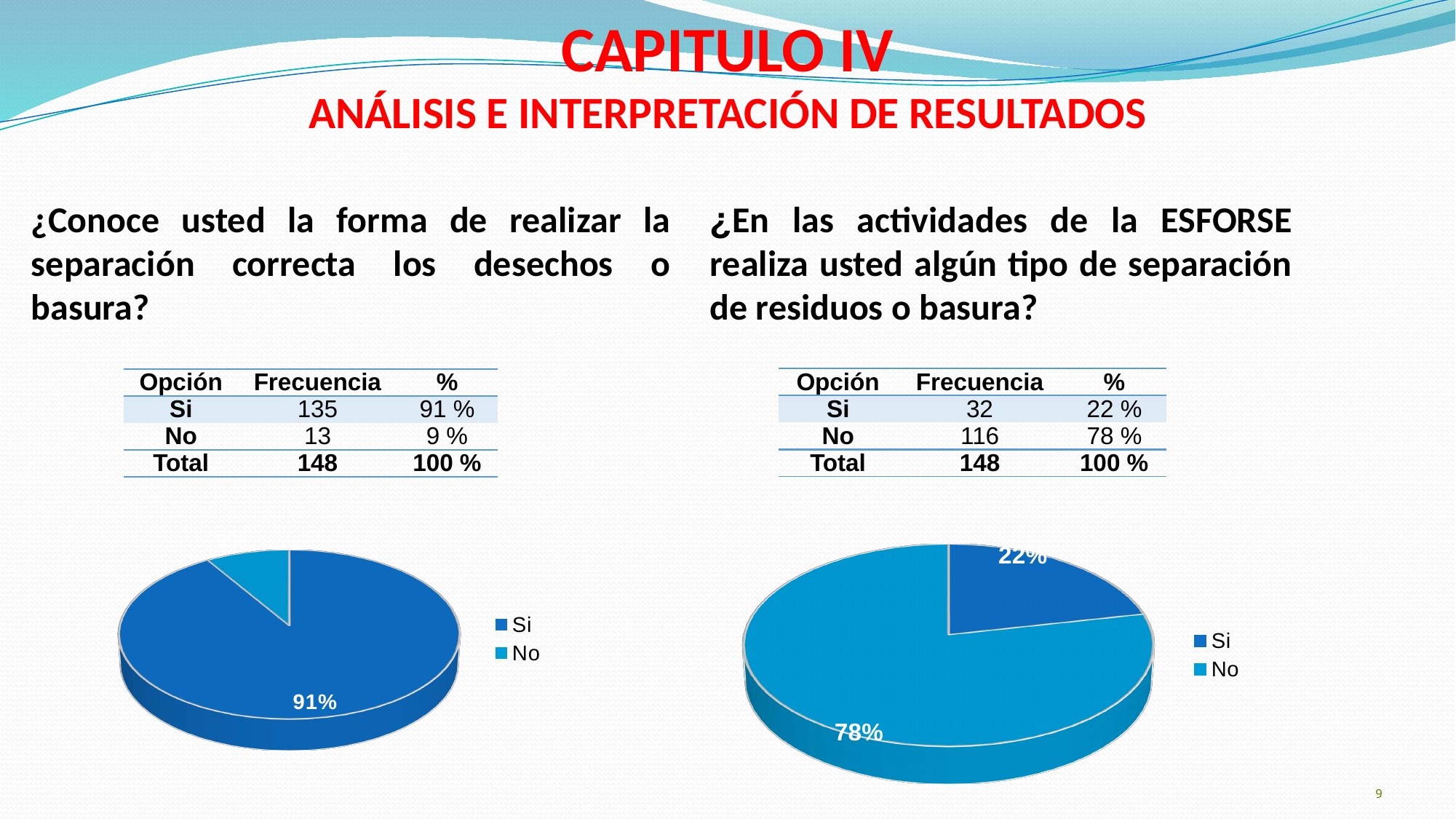
In the right pie chart, what is the difference in percentage points between No and Si? 56 In the left pie chart, what share of the pie does No represent? 9% How many entries does the legend of the right pie chart list? 2 In the right pie chart, which option has the smallest slice? Si In the right pie chart, what percentage is shown for Si? 22% How many slices does the left pie chart have? 2 In the left pie chart, what percentage is shown for Si? 91% In the right pie chart, which is larger, Si or No? No In the right pie chart, what percentage is shown for No? 78% In the left pie chart, which option has the largest slice? Si In the right pie chart, what colour is the No slice? light blue What type of chart is shown on the left side of the slide? pie chart